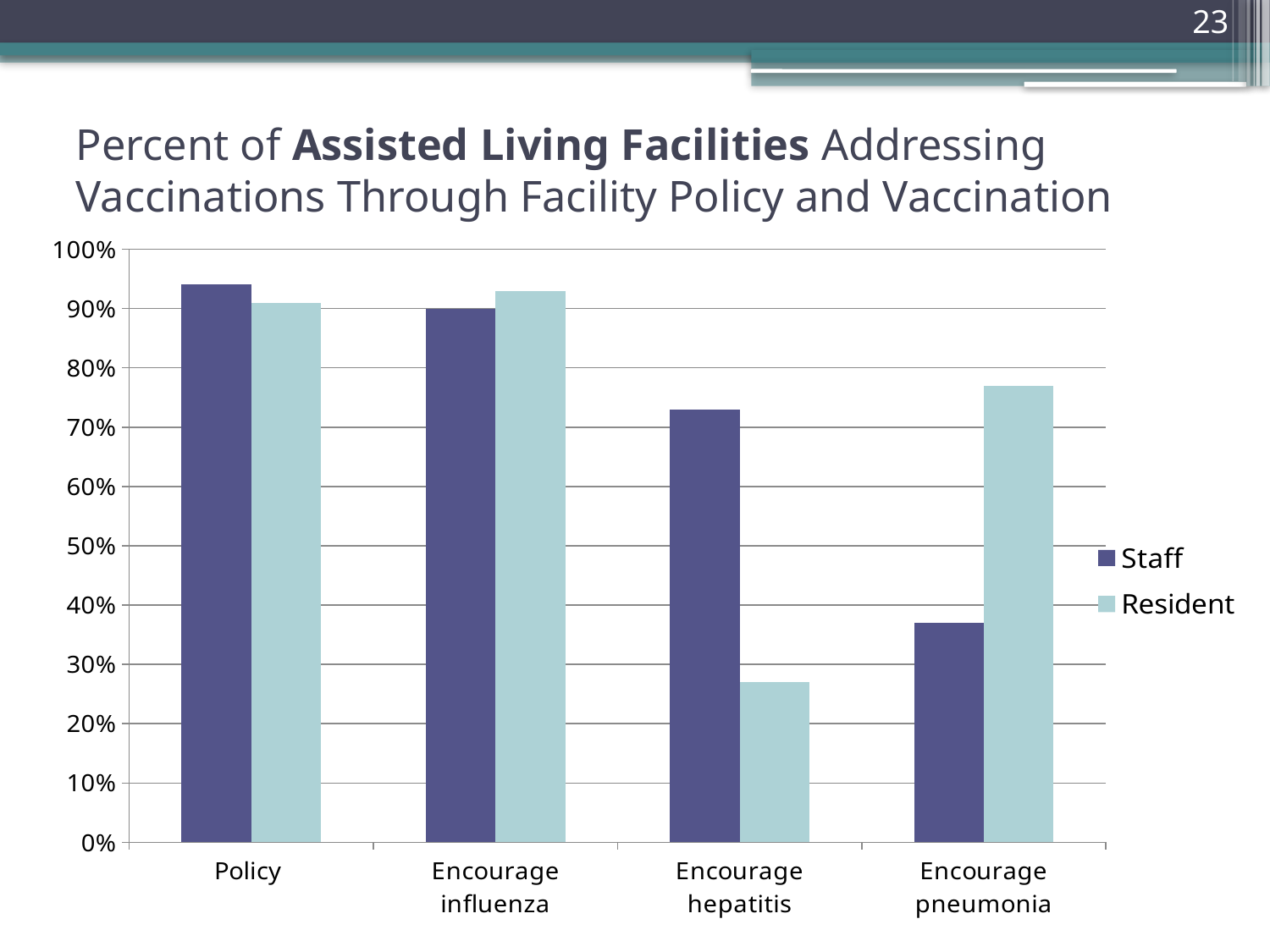
How many series does the legend list? 2 Which category has the lowest Resident value? Encourage hepatitis Is the Staff value for Encourage pneumonia greater or less than 40%? less Which category has the lowest Staff value? Encourage pneumonia What kind of chart is shown on the slide? bar chart Is the Resident value for Encourage hepatitis greater or less than 30%? less How many categories are shown on the x axis? 4 What are the two series named in the legend? Staff and Resident Which category has the highest Staff value? Policy Is the Resident value for Encourage pneumonia greater or less than 70%? greater For Encourage hepatitis, which is larger, the Staff value or the Resident value? Staff For Encourage pneumonia, which is larger, the Staff value or the Resident value? Resident